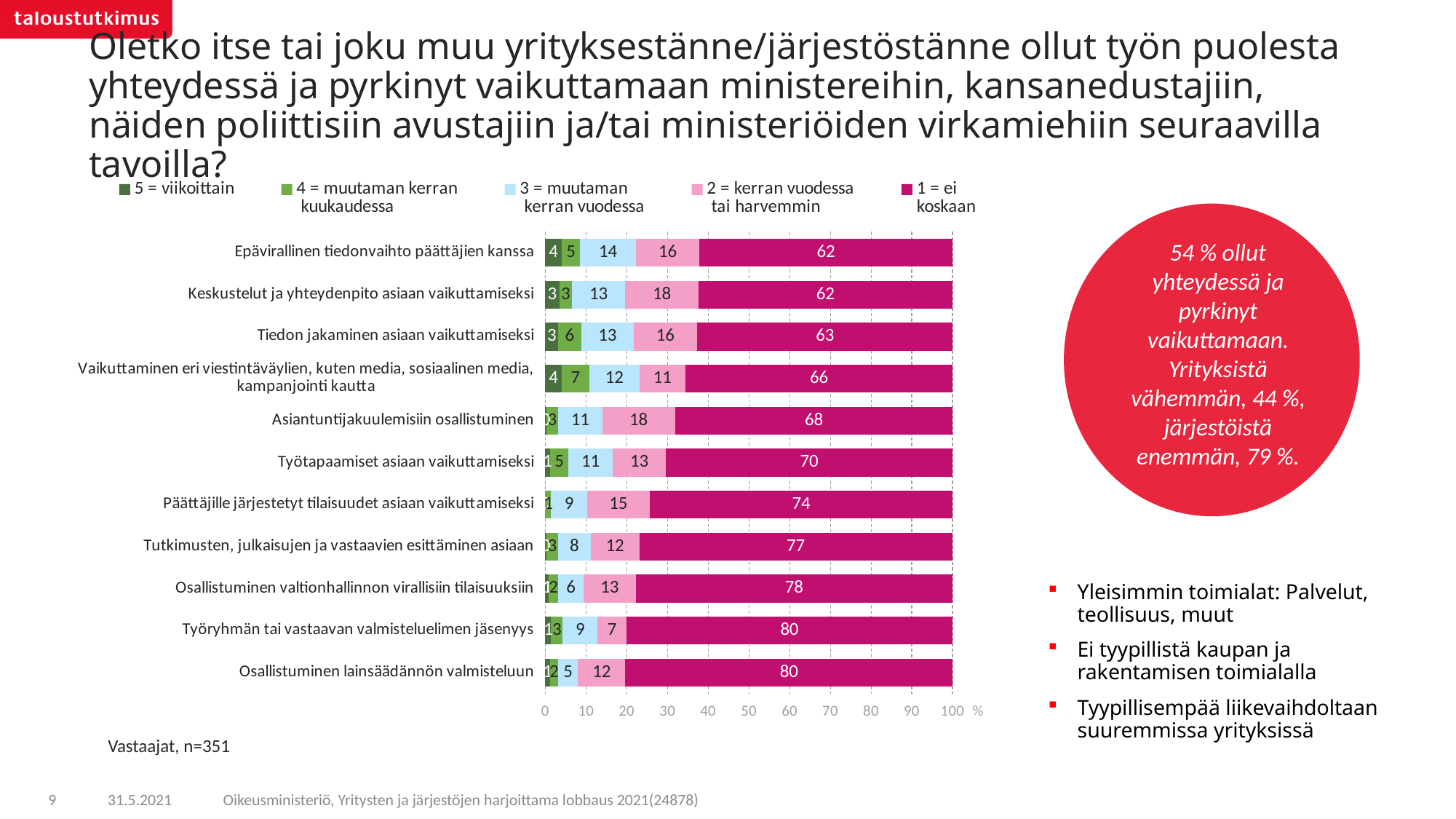
Is the '1 = ei koskaan' value for 'Päättäjille järjestetyt tilaisuudet asiaan vaikuttamiseksi' greater or less than 70? greater Which category has the lowest value for '1 = ei koskaan'? Epävirallinen tiedonvaihto päättäjien kanssa and Keskustelut ja yhteydenpito asiaan vaikuttamiseksi (62) What is the value of '1 = ei koskaan' for 'Epävirallinen tiedonvaihto päättäjien kanssa'? 62 What is the number of respondents (n) stated below the chart? n=351 What is the difference between the '1 = ei koskaan' values for 'Osallistuminen lainsäädännön valmisteluun' and 'Työtapaamiset asiaan vaikuttamiseksi'? 10 Which is larger: the '3 = muutaman kerran vuodessa' value for 'Epävirallinen tiedonvaihto päättäjien kanssa' or for 'Tutkimusten, julkaisujen ja vastaavien esittäminen asiaan'? Epävirallinen tiedonvaihto päättäjien kanssa What is the value of '2 = kerran vuodessa tai harvemmin' for 'Asiantuntijakuulemisiin osallistuminen'? 18 What is the value of '4 = muutaman kerran kuukaudessa' for 'Vaikuttaminen eri viestintäväylien, kuten media, sosiaalinen media, kampanjointi kautta'? 7 How many series does the legend list? 5 What type of chart is shown on the slide? stacked bar chart What is the value of '3 = muutaman kerran vuodessa' for 'Keskustelut ja yhteydenpito asiaan vaikuttamiseksi'? 13 How many categories (rows) are plotted in the chart? 11